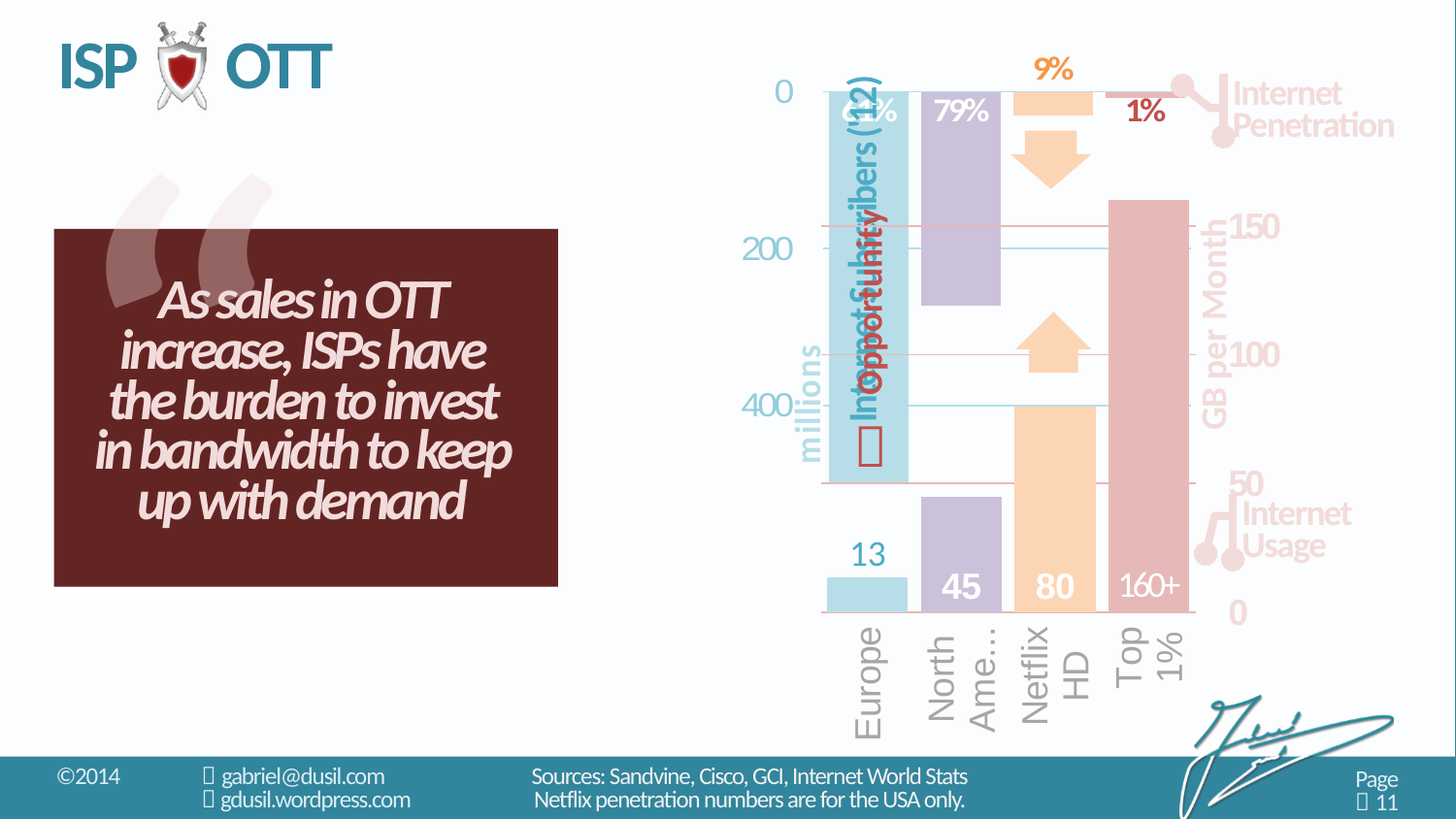
What Internet Penetration percentage is shown for Netflix HD? 9% What Internet Penetration percentage is shown for North America? 79% What is the Internet Usage value shown for Europe? 13 What is the difference between the Internet Usage values for Netflix HD and North America? 35 What Internet Penetration percentage is shown for the Top 1% category? 1% What is the Internet Usage value shown for North America? 45 Which category has the lowest Internet Usage value? Europe What is the Internet Usage value shown for the Top 1% category? 160+ How many categories are shown on the x axis of the chart? 4 What is the Internet Usage value shown for Netflix HD? 80 What unit is shown on the right-hand axis of the chart? GB per Month Which has a higher Internet Usage value, Netflix HD or North America? Netflix HD